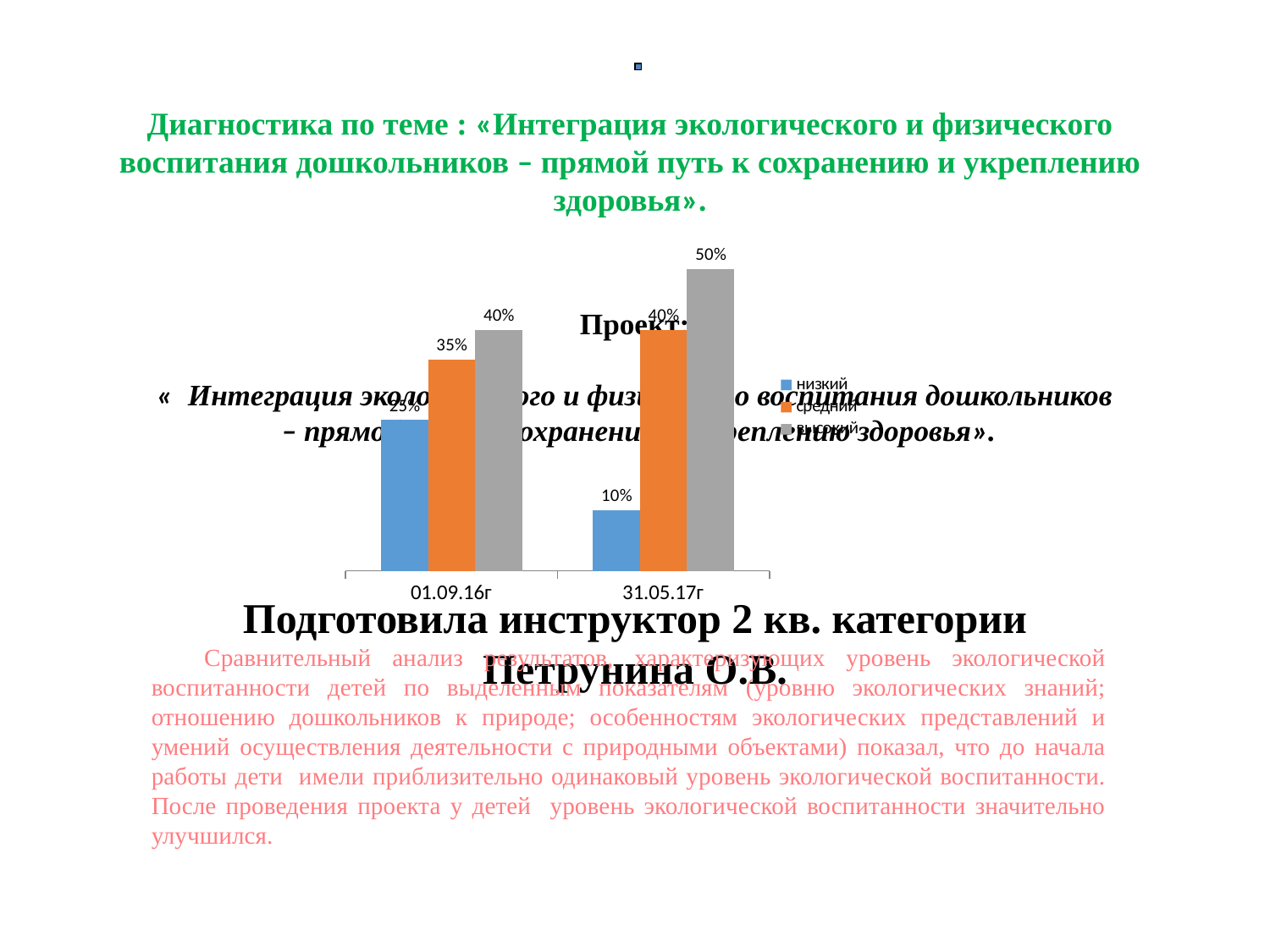
Which date has the larger value for the высокий series, 01.09.16г or 31.05.17г? 31.05.17г By how much did the высокий series increase from 01.09.16г to 31.05.17г? 10% What is the value of the высокий series for 01.09.16г? 40% Which series has the lowest value for 31.05.17г? низкий What is the value of the средний series for 01.09.16г? 35% Which series has the highest value for 31.05.17г? высокий What is the value of the низкий series for 31.05.17г? 10% What is the value of the средний series for 31.05.17г? 40% How many categories (dates) are shown on the x axis? 2 What is the value of the высокий series for 31.05.17г? 50% What kind of chart is shown on the slide? bar chart How many series does the legend list? 3